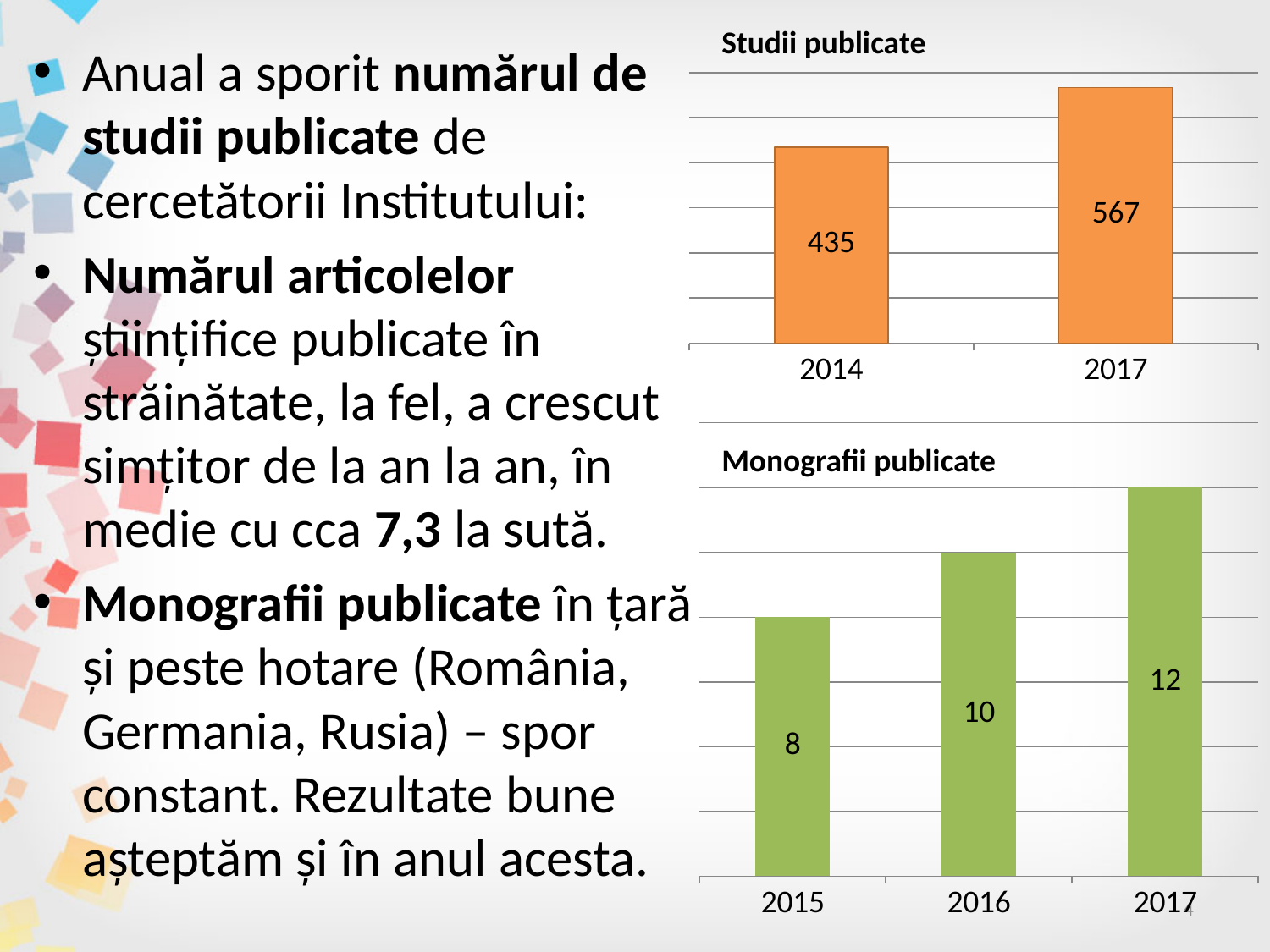
In the 'Monografii publicate' chart, which year has the lowest value? 2015 In the 'Monografii publicate' chart, do the values rise or fall from 2015 to 2017? rise In the 'Studii publicate' chart, how many years are shown? 2 In the 'Monografii publicate' chart, what is the value for 2015? 8 In the 'Monografii publicate' chart, how many years are shown? 3 What kind of chart is the 'Studii publicate' chart? bar chart In the 'Monografii publicate' chart, what is the difference between the 2017 and 2015 values? 4 In the 'Studii publicate' chart, what is the difference between the 2017 and 2014 values? 132 In the 'Studii publicate' chart, what is the value for 2017? 567 In the 'Monografii publicate' chart, what is the value for 2016? 10 In the 'Studii publicate' chart, which year has the higher value? 2017 In the 'Studii publicate' chart, what is the value for 2014? 435